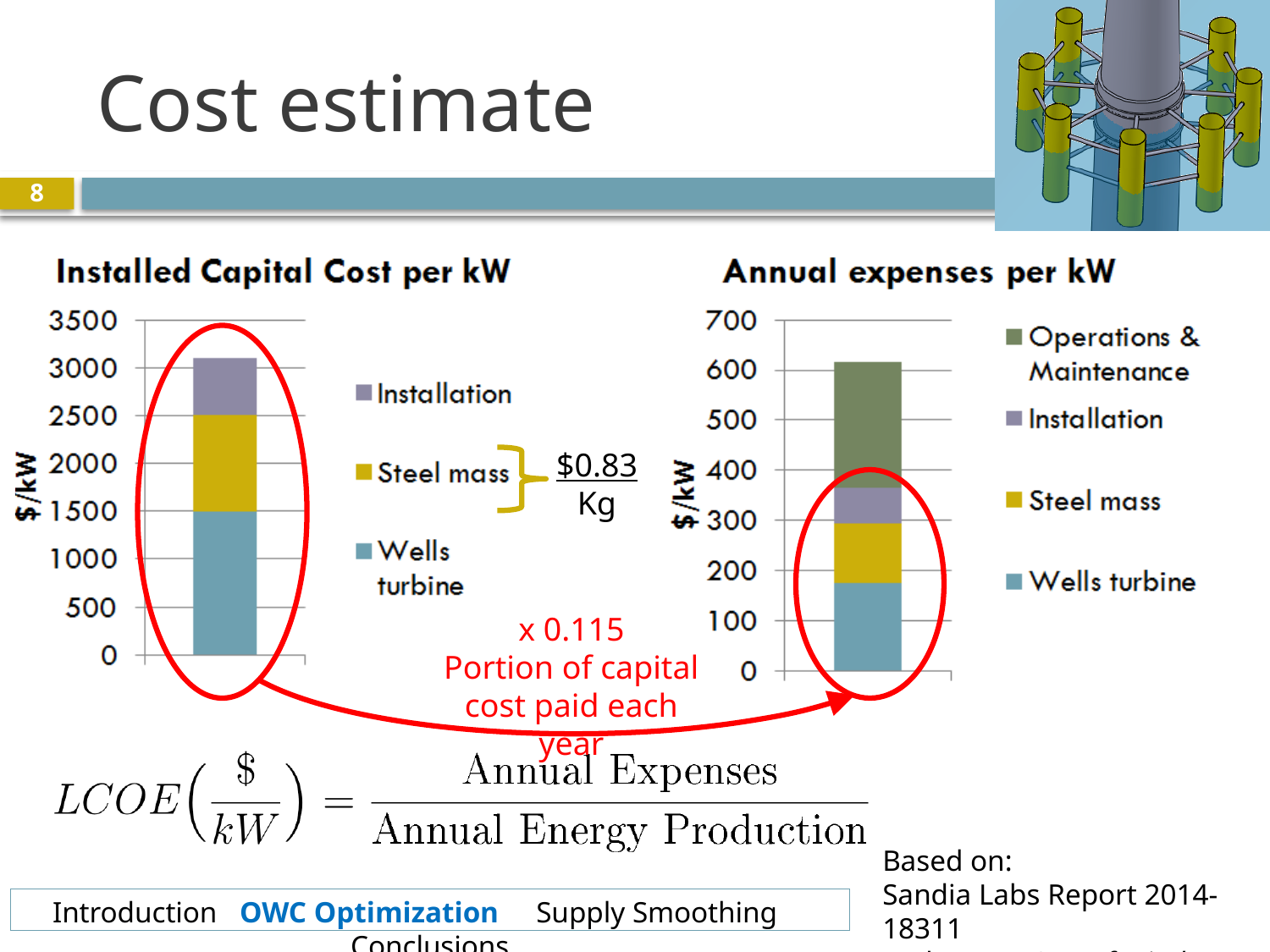
In the 'Annual expenses per kW' chart, which series makes up the smallest segment of the bar? Installation How many series does the legend of the 'Installed Capital Cost per kW' chart list? 3 In the 'Installed Capital Cost per kW' chart, which series makes up the smallest segment of the bar? Installation In the 'Annual expenses per kW' chart, is the Wells turbine segment greater or less than 200? less In the 'Annual expenses per kW' chart, which series makes up the largest segment of the bar? Operations & Maintenance How many series does the legend of the 'Annual expenses per kW' chart list? 4 In the 'Installed Capital Cost per kW' chart, is the total height of the stacked bar greater or less than 3000? greater What is the y-axis label on the 'Annual expenses per kW' chart? $/kW In the 'Annual expenses per kW' chart, is the total height of the stacked bar greater or less than 700? less In the 'Installed Capital Cost per kW' chart, which is larger: the Steel mass segment or the Installation segment? Steel mass In the 'Installed Capital Cost per kW' chart, which series makes up the largest segment of the bar? Wells turbine What kind of chart is the 'Installed Capital Cost per kW' chart? Stacked bar chart